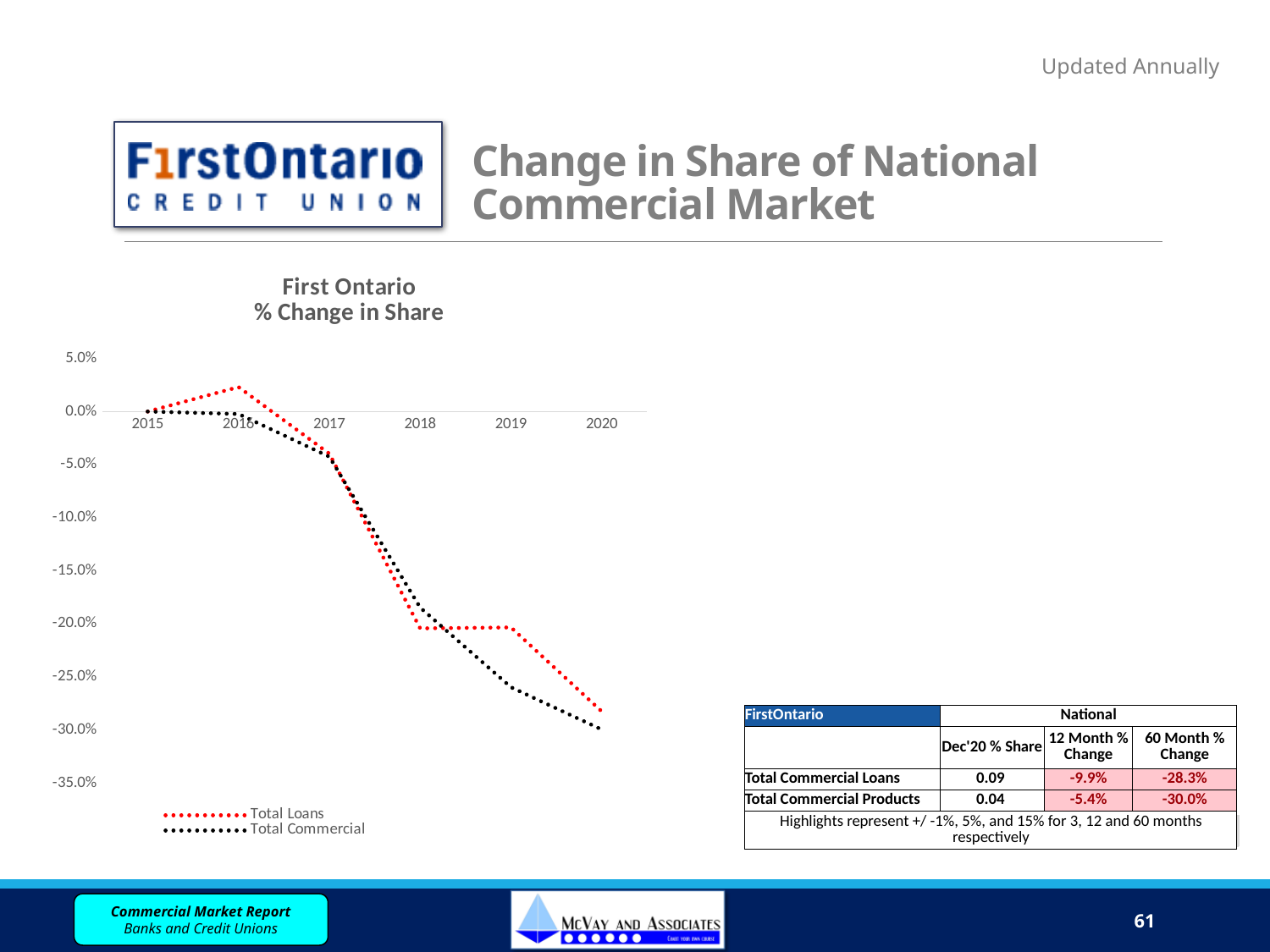
What is the title of the chart? First Ontario % Change in Share What kind of chart is shown on the slide? line chart How many years are shown on the x axis of the chart? 6 In 2016, which series has the higher value, Total Loans or Total Commercial? Total Loans How many series does the chart legend list? 2 Is the value for Total Loans in 2016 greater or less than 0.0%? greater Which series is drawn with the red dotted line? Total Loans Is the value for Total Commercial in 2020 greater or less than -25.0%? less In 2019, which series has the higher value, Total Loans or Total Commercial? Total Loans Is the value for Total Loans in 2018 greater or less than -15.0%? less Overall, do the values for Total Commercial rise or fall from 2015 to 2020? fall